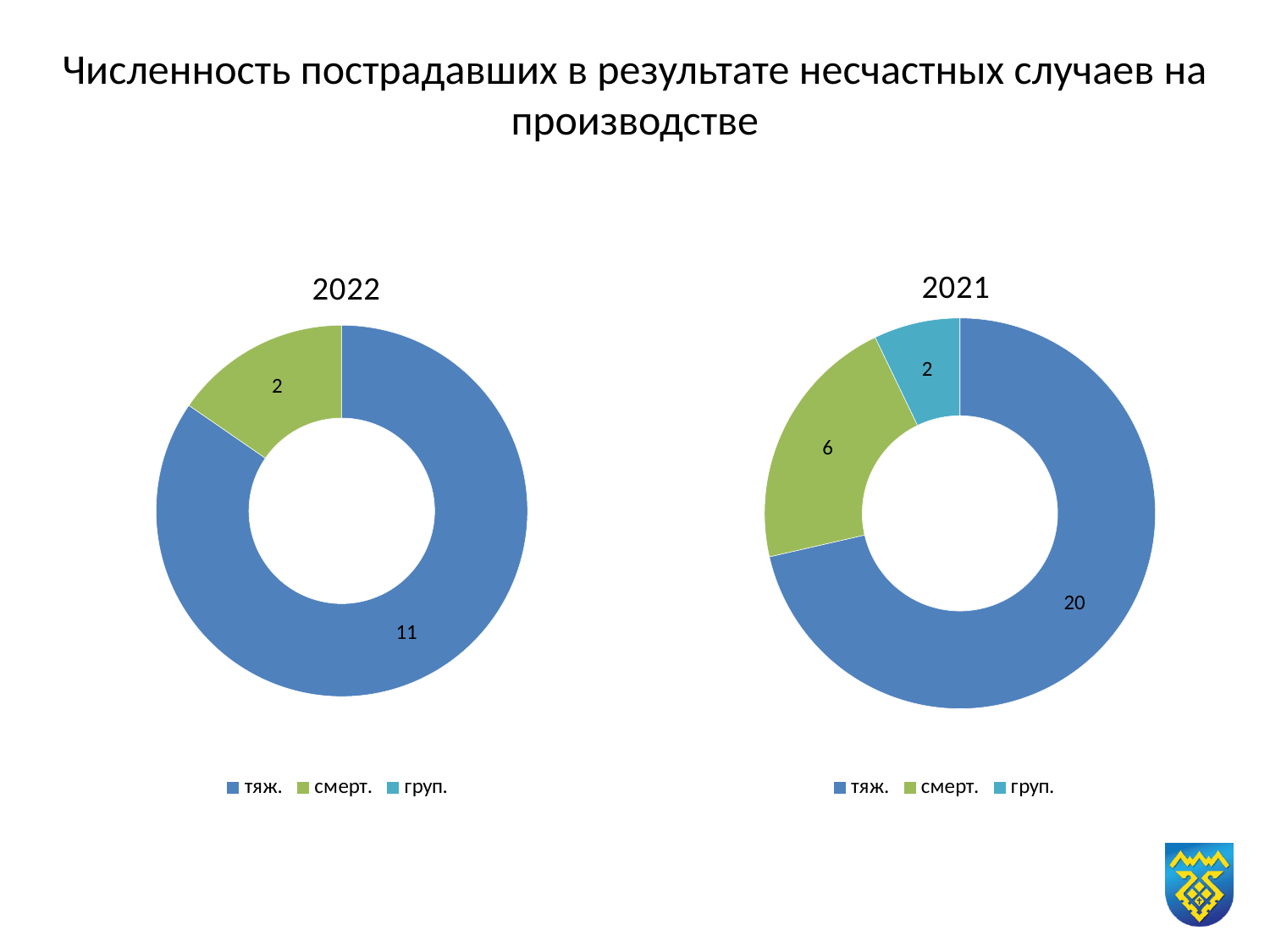
In the 2021 chart, what is the value for тяж.? 20 In the 2021 chart, which category has the largest slice? тяж. In the 2021 chart, which category has the smallest slice? груп. What kind of chart is the 2022 chart? doughnut chart In the 2022 chart, what is the value for смерт.? 2 In the 2021 chart, what is the value for груп.? 2 In the 2021 chart, what is the difference between the values for тяж. and смерт.? 14 In the 2021 chart, what is the total of all the slices? 28 In the 2021 chart, what is the value for смерт.? 6 Which is larger: the value for тяж. in the 2022 chart or the value for тяж. in the 2021 chart? 2021 In the 2022 chart, what is the value for тяж.? 11 How many slices are visible in the 2021 chart? 3